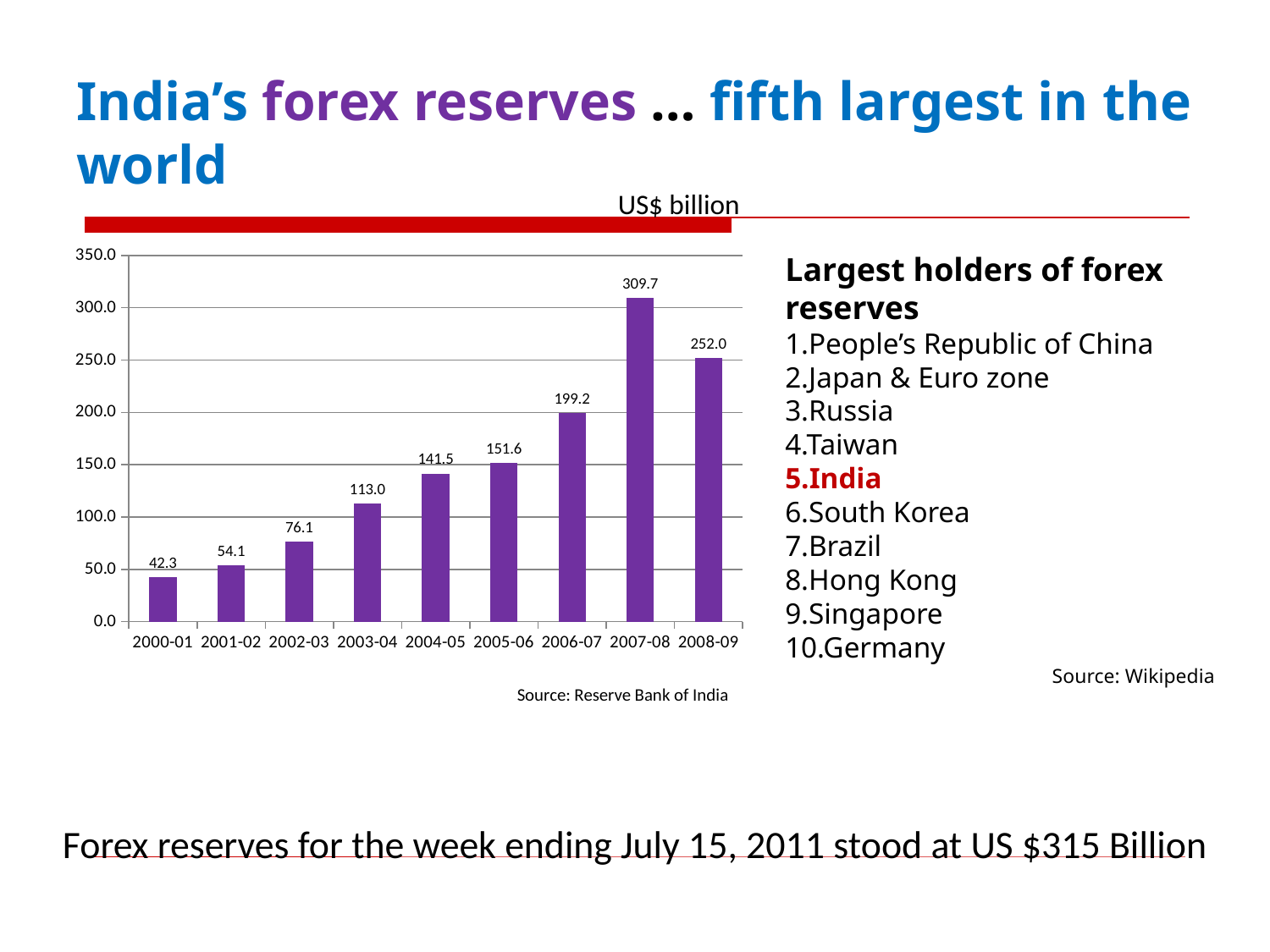
How many years are shown on the x axis? 9 Which year has the highest value? 2007-08 Which year has the lowest value? 2000-01 What is the value for 2007-08? 309.7 Which is larger, the value for 2003-04 or the value for 2002-03? 2003-04 What is the difference between the values for 2006-07 and 2005-06? 47.6 What unit is shown above the chart? US$ billion What kind of chart is shown on the slide? bar chart What is the value for 2000-01? 42.3 What is the value for 2004-05? 141.5 What is the difference between the values for 2007-08 and 2008-09? 57.7 Is the value for 2006-07 greater or less than 150.0? greater